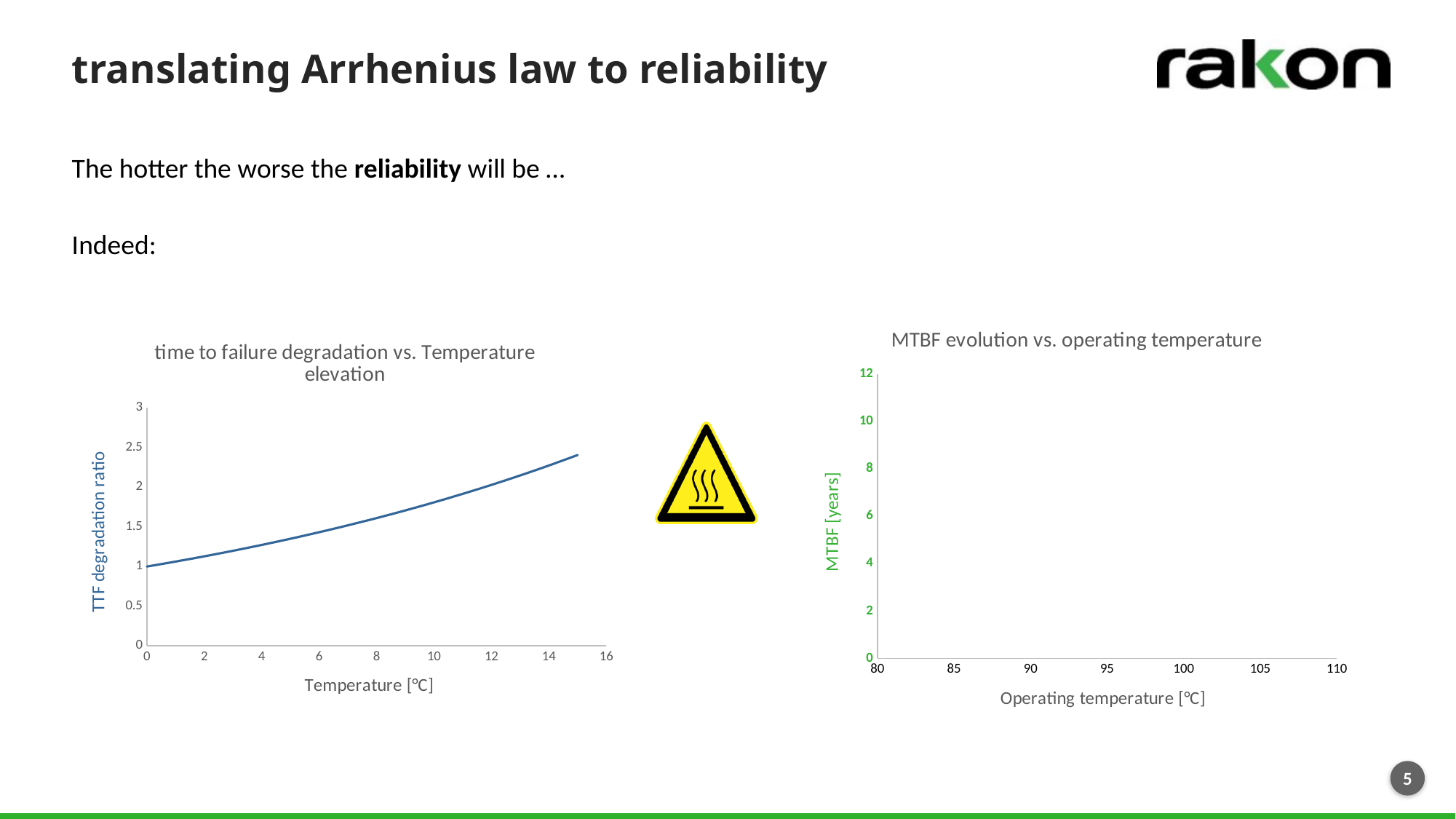
In the 'time to failure degradation vs. Temperature elevation' chart, does the TTF degradation ratio rise or fall as temperature increases? rise What is the x-axis title of the 'time to failure degradation vs. Temperature elevation' chart? Temperature [°C] In the 'time to failure degradation vs. Temperature elevation' chart, is the TTF degradation ratio at a temperature of 10 greater or less than 1.5? greater In the 'time to failure degradation vs. Temperature elevation' chart, is the TTF degradation ratio at a temperature of 0 greater or less than 2? less In the 'time to failure degradation vs. Temperature elevation' chart, is the TTF degradation ratio at a temperature of 14 greater or less than 2? greater In the 'time to failure degradation vs. Temperature elevation' chart, which is larger: the TTF degradation ratio at a temperature of 14 or at a temperature of 2? at 14 What kind of chart is the 'time to failure degradation vs. Temperature elevation' chart? line chart What is the y-axis title of the 'MTBF evolution vs. operating temperature' chart? MTBF [years]